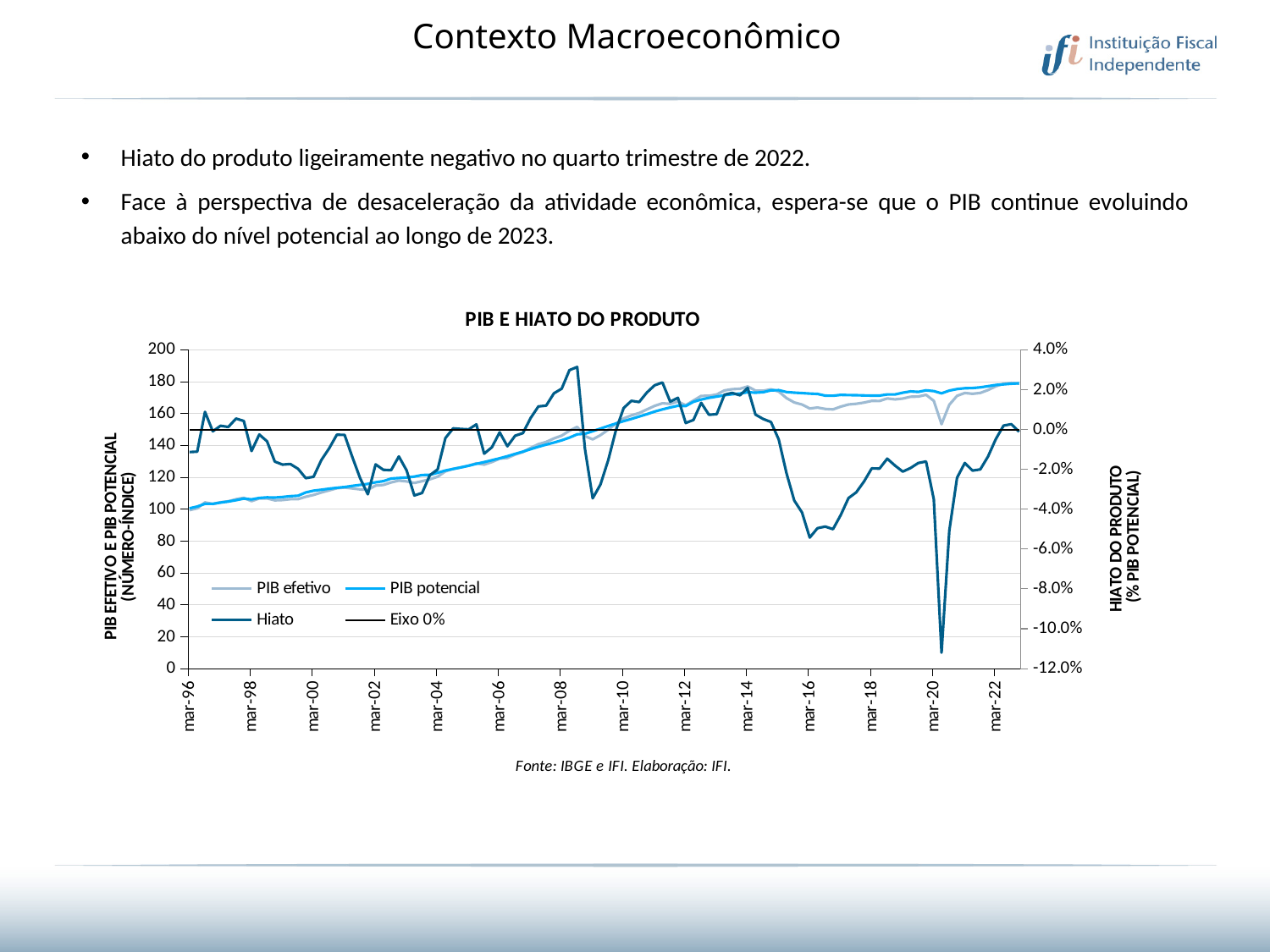
Does the PIB potencial series rise or fall along the x axis from mar-96 to mar-22? rise How many series does the chart legend list? 4 Is the value of PIB potencial at mar-96 greater or less than 120? less Is the value of Hiato at mar-08 greater or less than 0.0%? greater What is the title of the chart? PIB E HIATO DO PRODUTO How many year labels are shown on the x axis? 14 Is the value of PIB potencial at mar-22 greater or less than 160? greater Which series are listed in the chart legend? PIB efetivo, PIB potencial, Hiato, Eixo 0% In which year does the Hiato series reach its lowest value? 2020 At mar-20, which is larger: PIB efetivo or PIB potencial? PIB potencial What kind of chart is shown on the slide? line chart